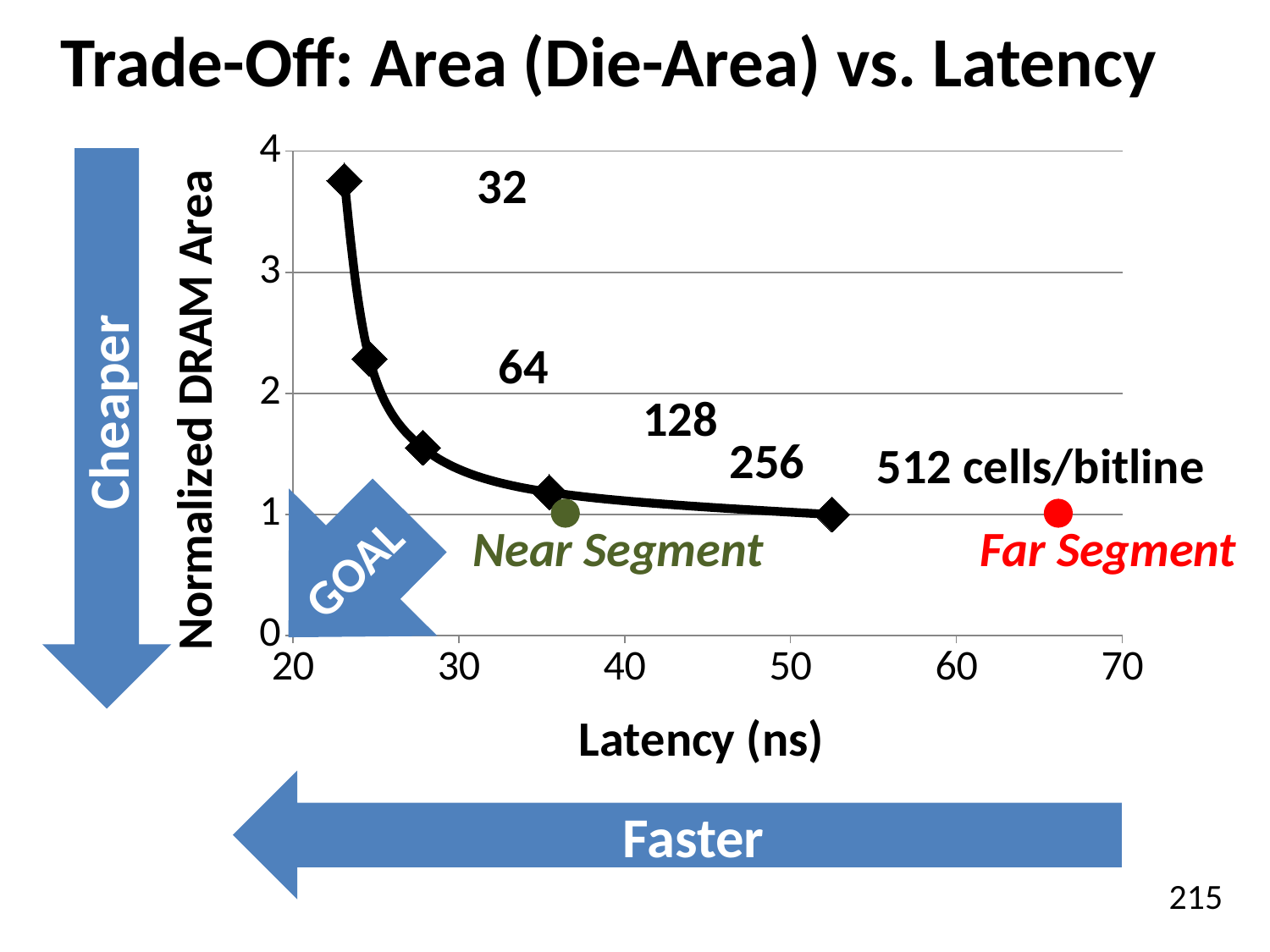
Which has the higher latency, the Near Segment point or the Far Segment point? Far Segment Is the normalized DRAM area for 32 cells/bitline greater or less than 3? greater Is the normalized DRAM area for 128 cells/bitline greater or less than 2? less Which cells/bitline configuration has the highest normalized DRAM area? 32 What kind of chart is shown on the slide? line chart As latency increases along the x axis, does the normalized DRAM area rise or fall? fall Is the normalized DRAM area for 64 cells/bitline greater or less than 2? greater How many diamond-marked data points are on the black curve? 5 What is the title of the y axis? Normalized DRAM Area Which cells/bitline configuration has the lowest normalized DRAM area? 512 What is the title of the x axis? Latency (ns)